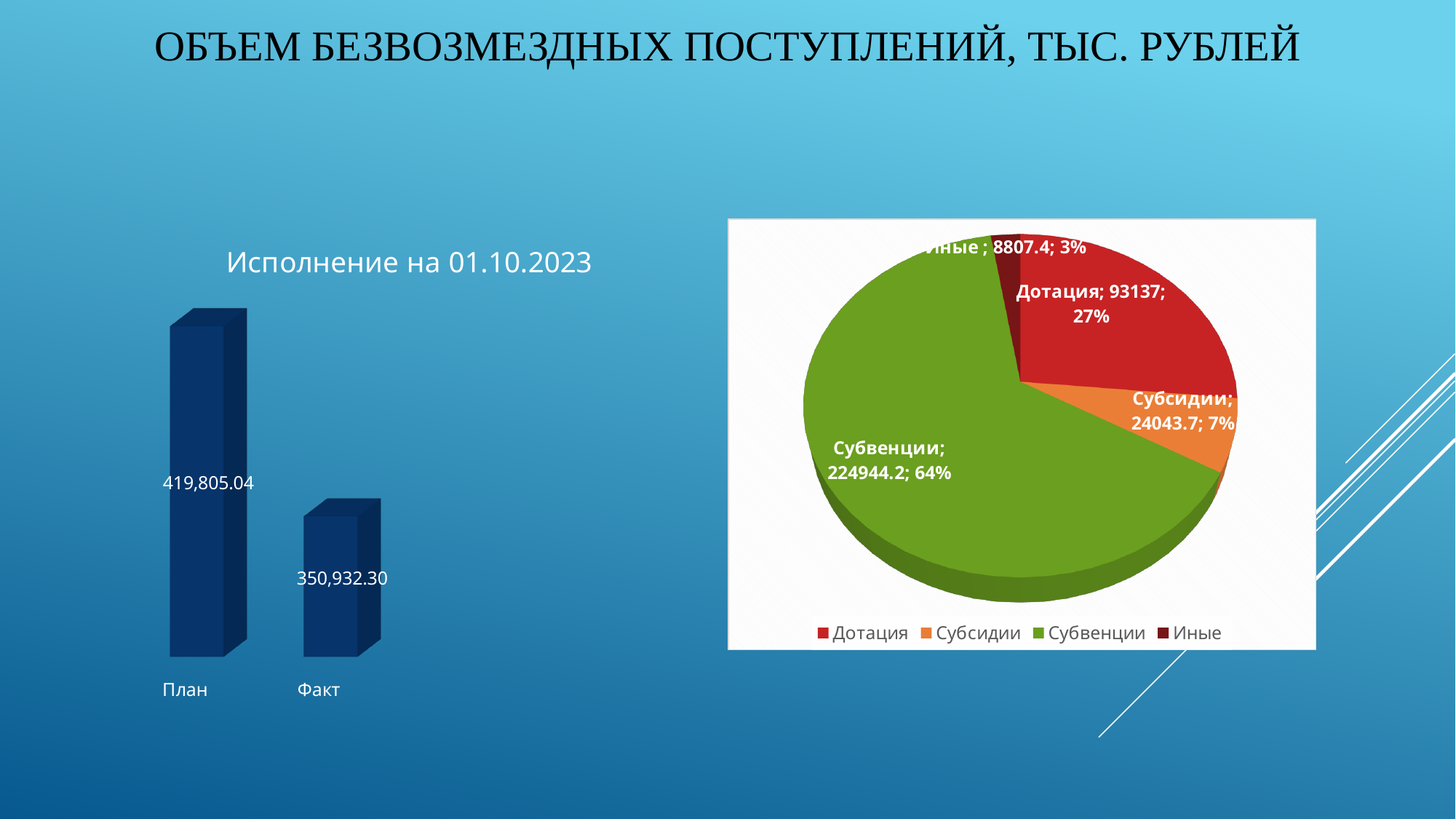
What type of chart is the chart on the left of the slide? Bar chart In the pie chart on the right, what share does Дотация have? 27% In the pie chart on the right, which category has the largest slice? Субвенции In the pie chart on the right, what is the value for Субсидии? 24043.7 In the bar chart 'Исполнение на 01.10.2023', what is the value for План? 419,805.04 In the bar chart 'Исполнение на 01.10.2023', which category has the higher value, План or Факт? План In the pie chart on the right, what is the value for Субвенции? 224944.2 In the bar chart 'Исполнение на 01.10.2023', what is the value for Факт? 350,932.30 In the bar chart 'Исполнение на 01.10.2023', how many categories are shown? 2 In the bar chart 'Исполнение на 01.10.2023', what is the difference between План and Факт? 68,872.74 How many entries does the legend of the pie chart on the right list? 4 In the pie chart on the right, which category has the smallest slice? Иные